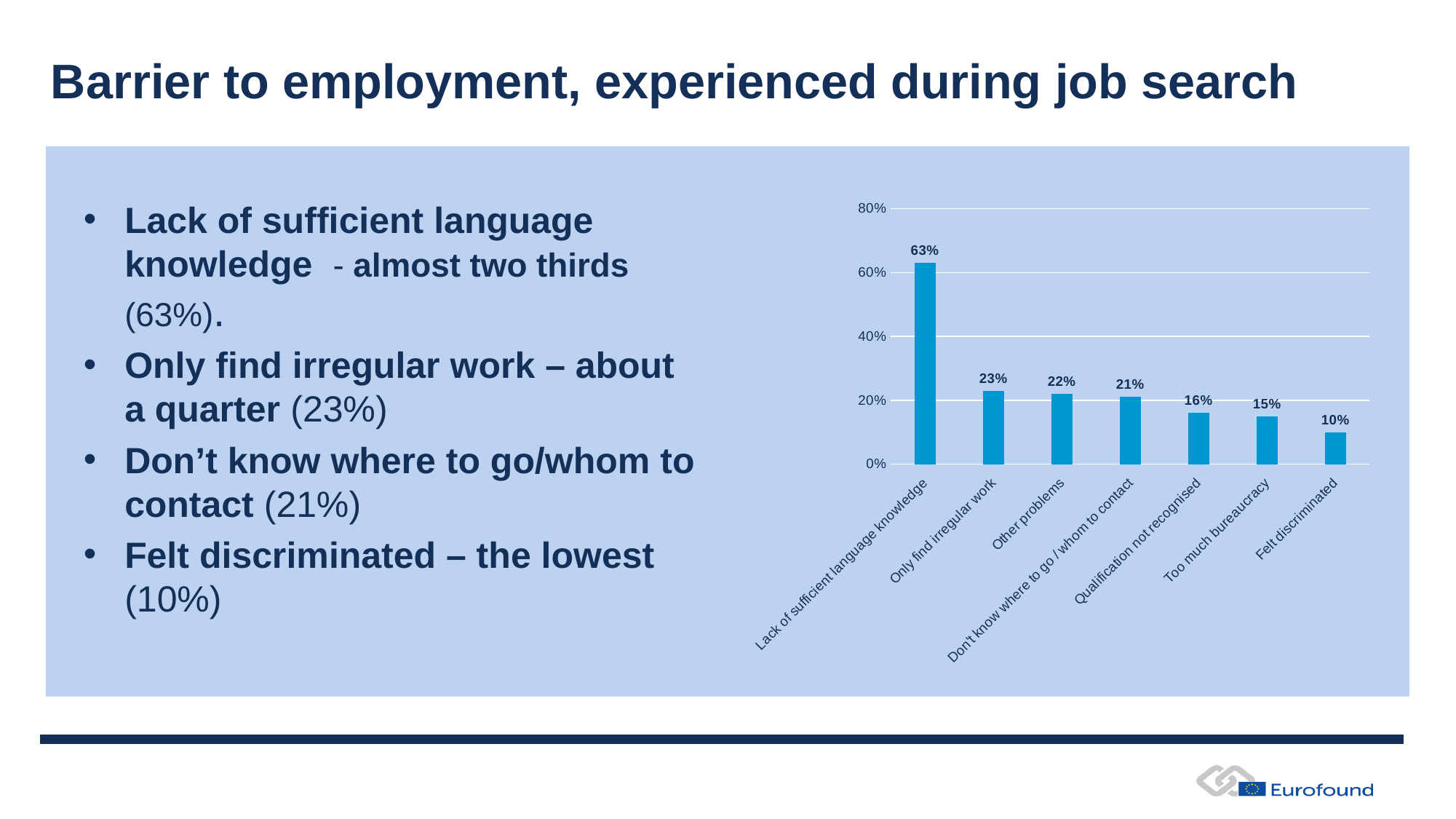
How many categories are shown in the chart? 7 What is the value for 'Other problems'? 22% What kind of chart is shown on the slide? bar chart Which category has the highest value? Lack of sufficient language knowledge What is the value for 'Qualification not recognised'? 16% Which is larger, 'Only find irregular work' or 'Too much bureaucracy'? Only find irregular work What is the value for 'Lack of sufficient language knowledge'? 63% What is the value for 'Too much bureaucracy'? 15% What is the difference between 'Lack of sufficient language knowledge' and 'Only find irregular work'? 40% Which category has the lowest value? Felt discriminated What is the difference between 'Qualification not recognised' and 'Felt discriminated'? 6% Is the value for 'Don't know where to go / whom to contact' greater or less than 40%? less